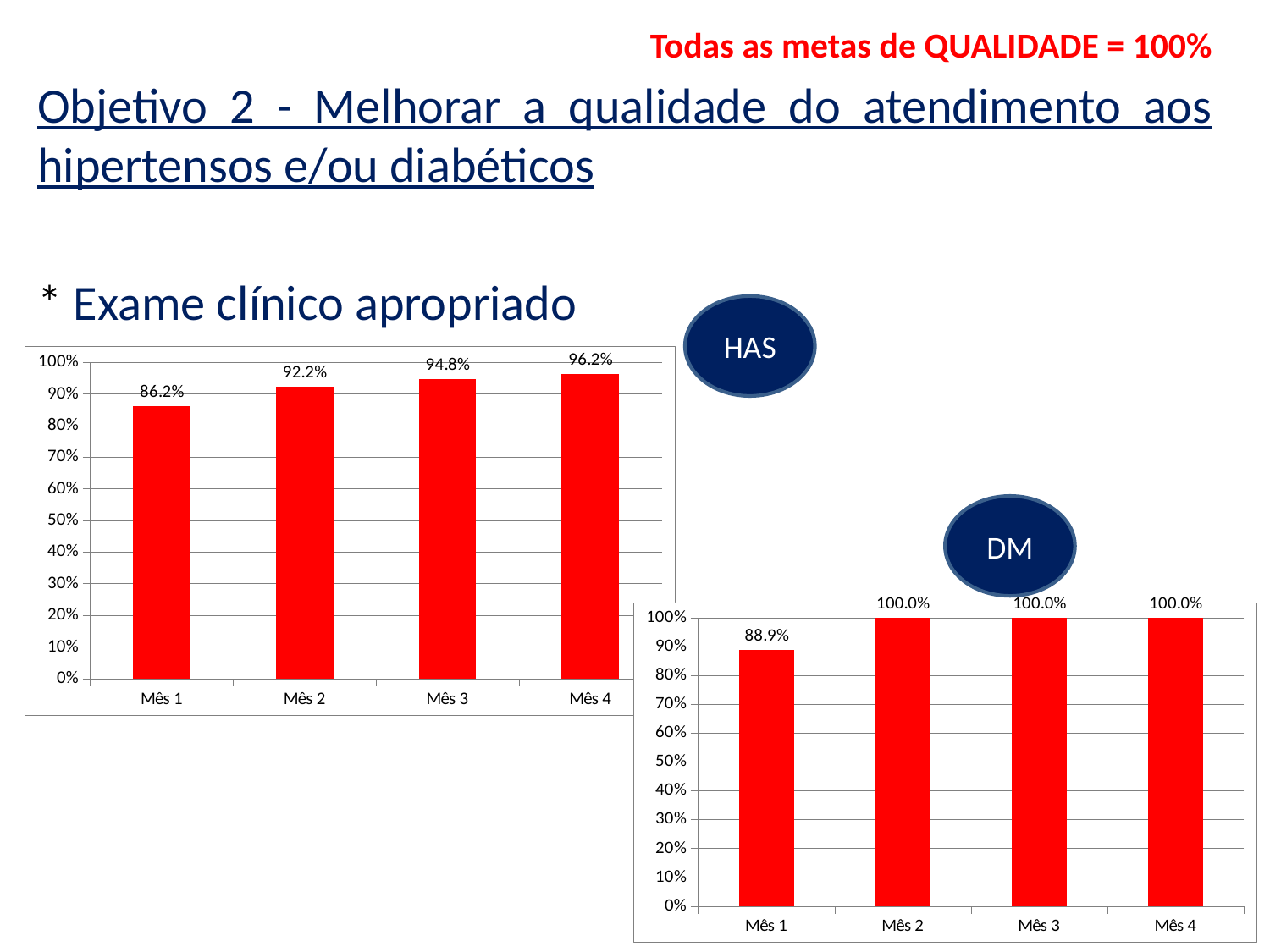
In the DM chart (lower right), what is the value for Mês 4? 100.0% In the DM chart (lower right), what is the value for Mês 1? 88.9% In the DM chart (lower right), which month has the lowest value? Mês 1 In the HAS chart (upper left), what is the value for Mês 1? 86.2% In the HAS chart (upper left), what is the value for Mês 3? 94.8% In the DM chart (lower right), what is the difference between the values for Mês 2 and Mês 1? 11.1% In the HAS chart (upper left), which month has the lowest value? Mês 1 In the HAS chart (upper left), what is the difference between the values for Mês 4 and Mês 1? 10.0% In the HAS chart (upper left), which month has the highest value? Mês 4 How many months are shown on the x axis of the HAS chart (upper left)? 4 Do the values in the HAS chart (upper left) rise or fall from Mês 1 to Mês 4? rise Which is larger: the Mês 2 value in the HAS chart or the Mês 2 value in the DM chart? DM chart